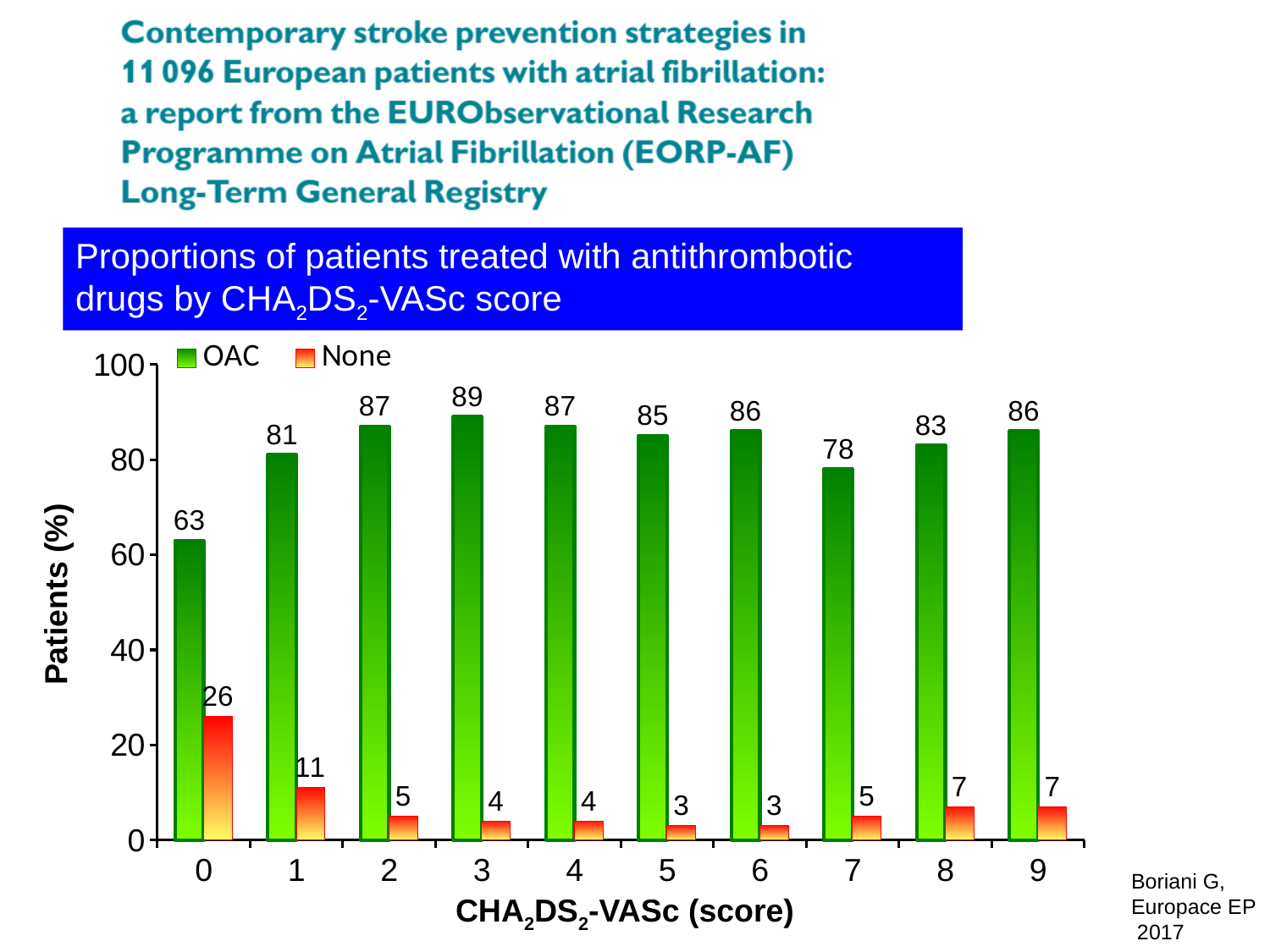
What is the OAC value for CHA2DS2-VASc score 0? 63 What is the label of the y axis? Patients (%) Which CHA2DS2-VASc score has the lowest OAC value? 0 Which CHA2DS2-VASc score has the highest None value? 0 Is the OAC value for score 1 larger than the OAC value for score 7? Yes How many series does the legend list? 2 How many CHA2DS2-VASc score categories are shown on the x axis? 10 What is the OAC value for CHA2DS2-VASc score 7? 78 Which CHA2DS2-VASc score has the highest OAC value? 3 What is the difference between the OAC value at score 3 and the OAC value at score 0? 26 What kind of chart is shown on the slide? Bar chart What is the None value for CHA2DS2-VASc score 1? 11